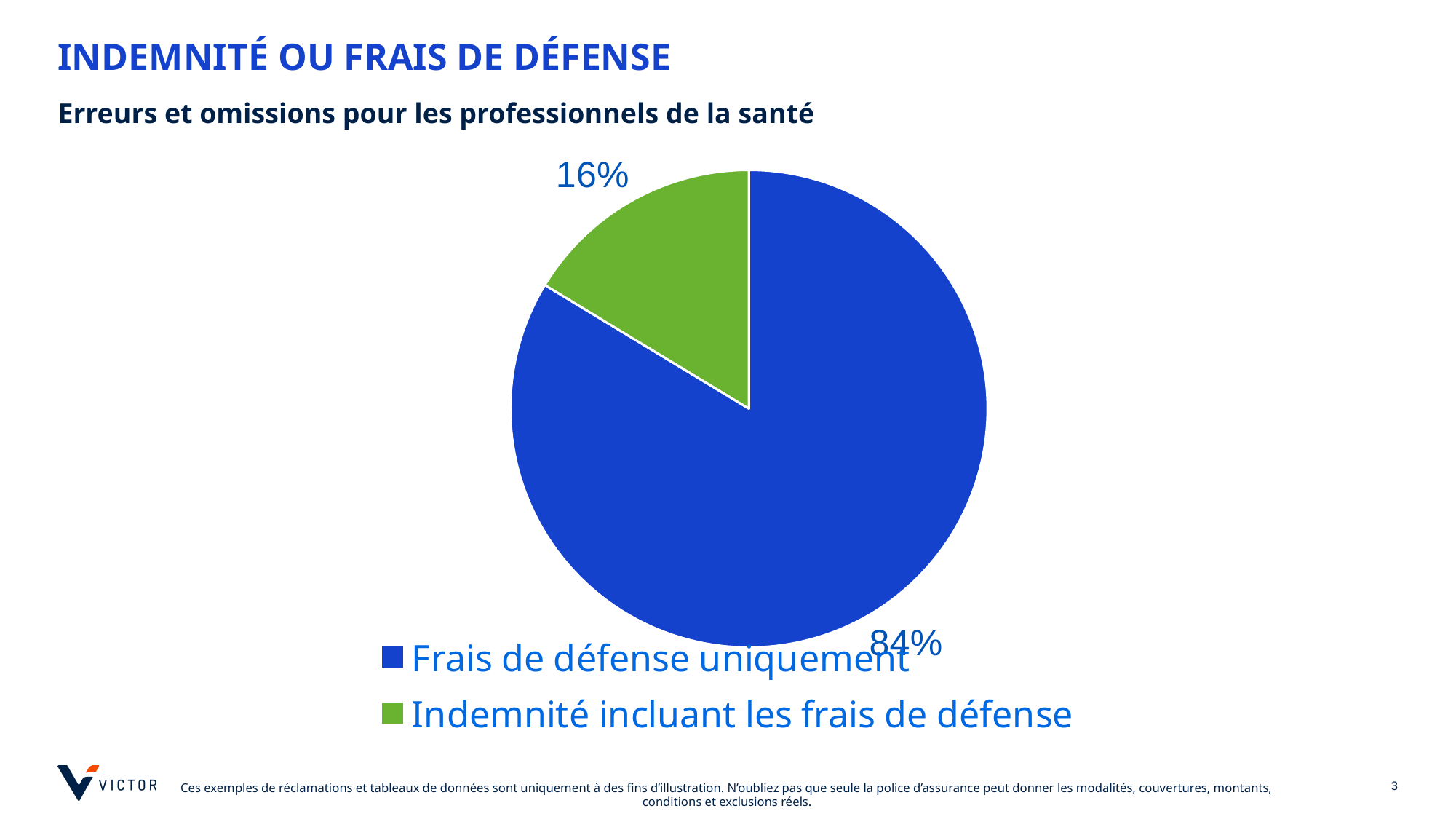
How many slices does the pie chart have? 2 What percentage of the pie is 'Indemnité incluant les frais de défense'? 16% What colour is the slice for 'Frais de défense uniquement'? Blue What kind of chart is shown on the slide? Pie chart How many entries does the legend list? 2 What percentage of the pie is 'Frais de défense uniquement'? 84% What is the difference in percentage points between 'Frais de défense uniquement' and 'Indemnité incluant les frais de défense'? 68 Which category has the smallest share of the pie? Indemnité incluant les frais de défense What colour is the slice for 'Indemnité incluant les frais de défense'? Green Which category has the largest share of the pie? Frais de défense uniquement Which is larger: 'Frais de défense uniquement' or 'Indemnité incluant les frais de défense'? Frais de défense uniquement